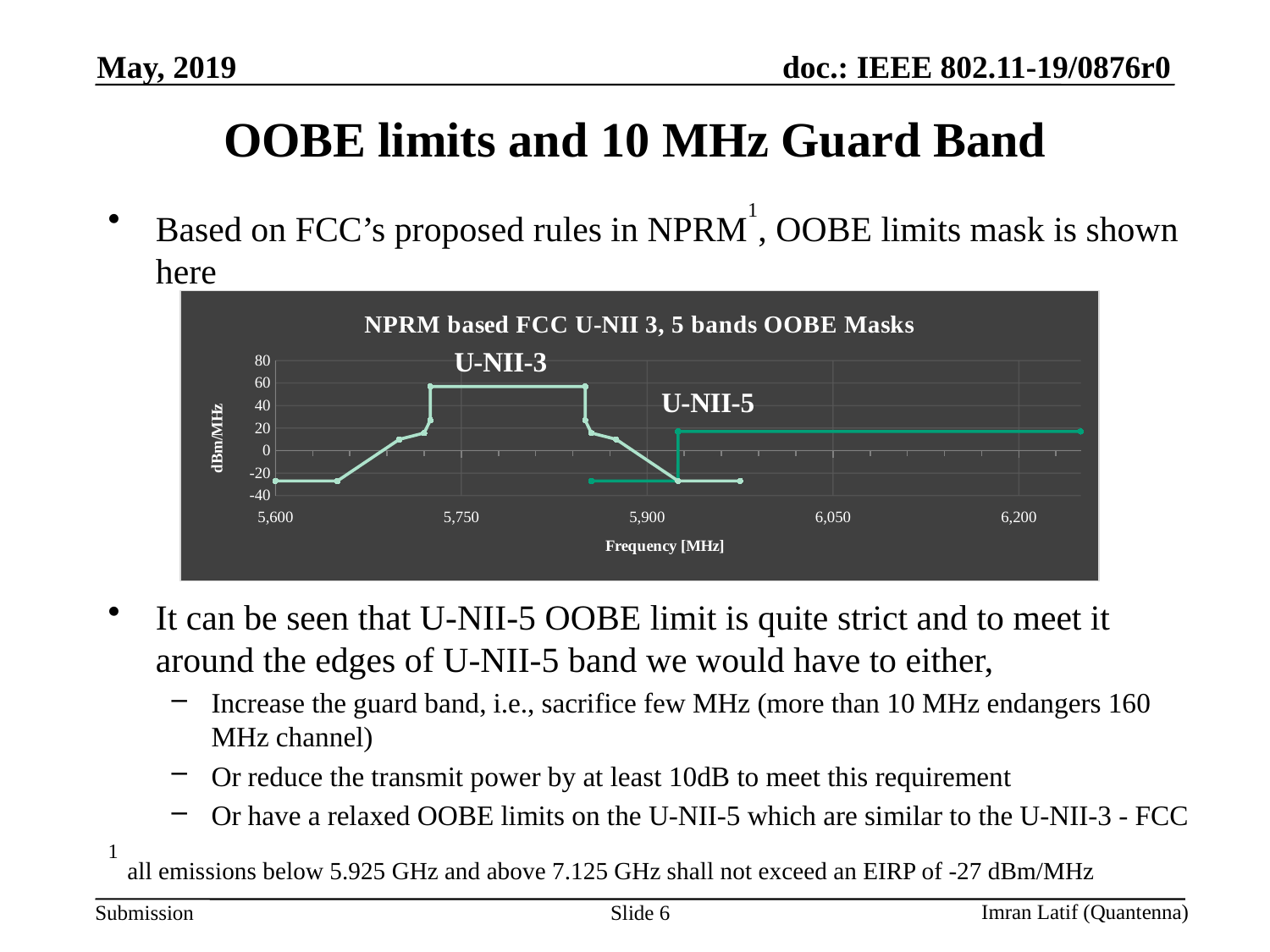
What is the title of the chart? NPRM based FCC U-NII 3, 5 bands OOBE Masks Does the U-NII-3 mask rise or fall as frequency increases from 5,600 MHz to 5,750 MHz? rise How many lines (series) are plotted in the chart? 2 Which mask reaches the higher peak value, U-NII-3 or U-NII-5? U-NII-3 What is the label of the x axis of the chart? Frequency [MHz] Is the value of the U-NII-3 mask at 5,600 MHz greater or less than -20 dBm/MHz? less Is the flat upper level of the U-NII-5 mask (above about 5,925 MHz) greater or less than 0 dBm/MHz? greater What kind of chart is shown on the slide? line chart Does the U-NII-3 mask rise or fall as frequency increases from 5,850 MHz to 5,900 MHz? fall Is the peak value of the U-NII-3 mask greater or less than 40 dBm/MHz? greater